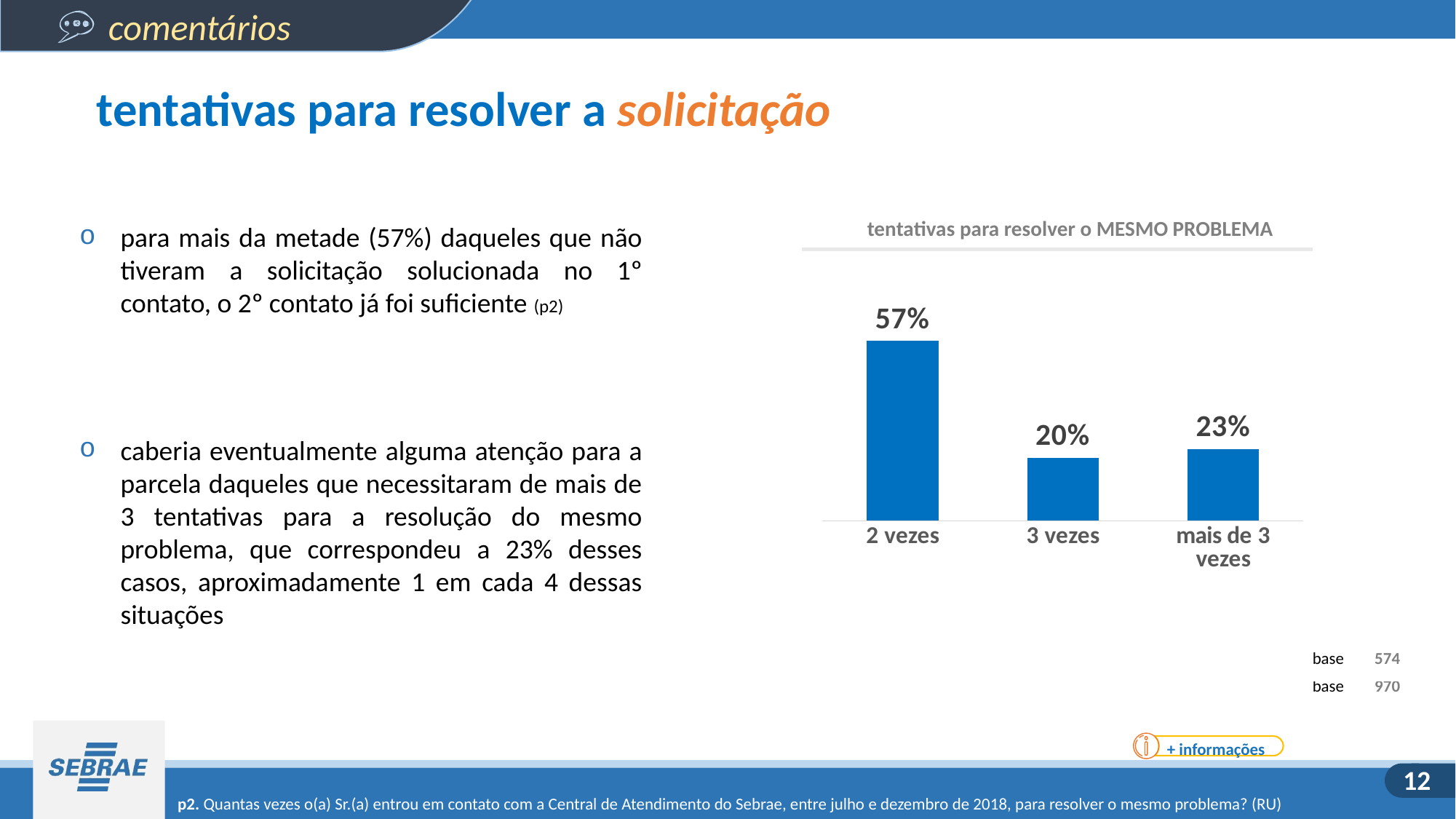
What kind of chart is shown on the slide? bar chart What is the value for "mais de 3 vezes"? 23% Which is larger, the value for "2 vezes" or the value for "mais de 3 vezes"? 2 vezes Which category has the lowest value? 3 vezes What is the title of the chart? tentativas para resolver o MESMO PROBLEMA What is the difference between the values for "mais de 3 vezes" and "3 vezes"? 3% How many categories are shown in the chart? 3 What is the value for "2 vezes"? 57% What is the value for "3 vezes"? 20% What colour are the bars in the chart? blue What is the difference between the values for "2 vezes" and "3 vezes"? 37% Which category has the highest value? 2 vezes